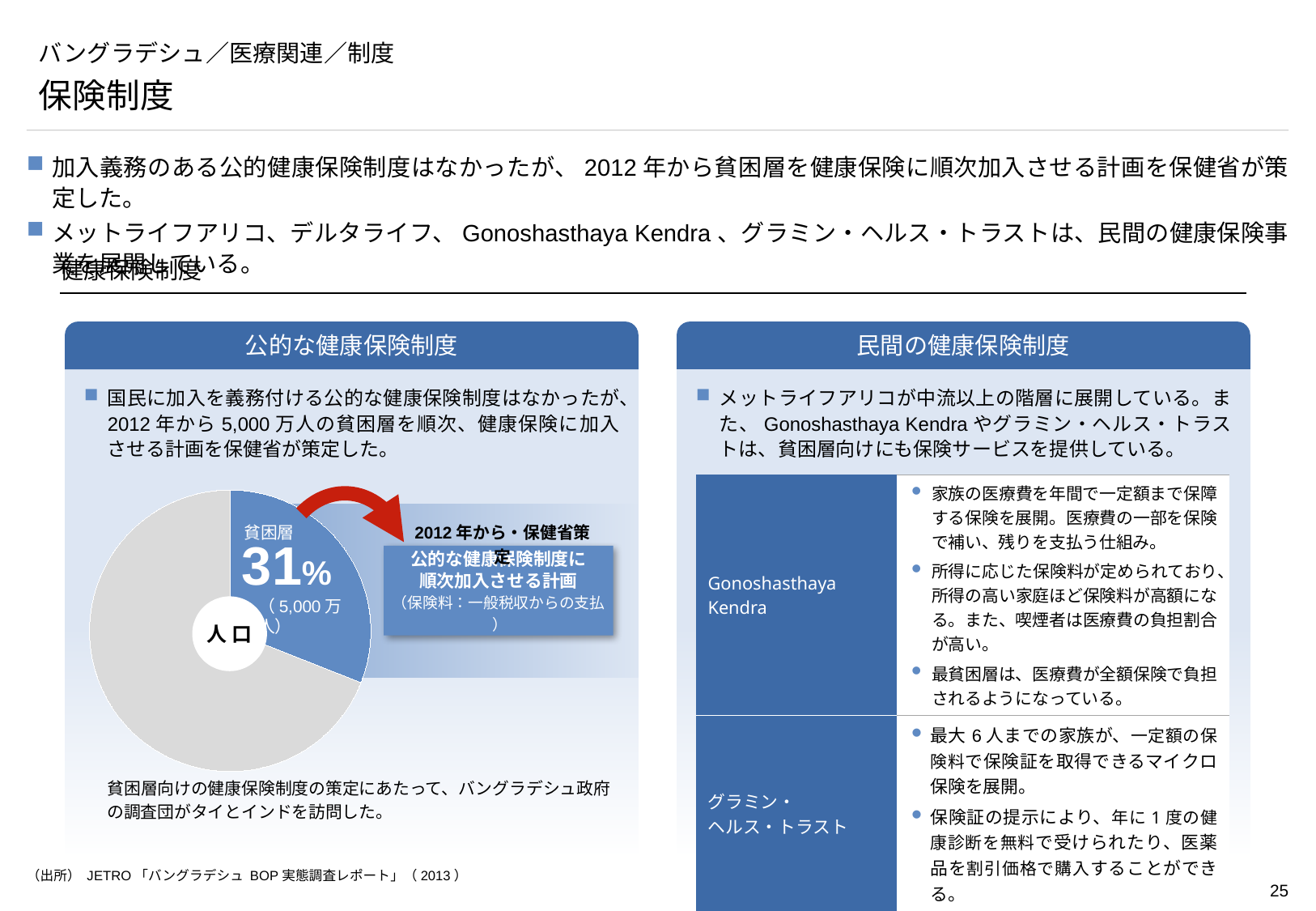
What label appears in the centre of the donut chart? 人口 What percentage of the population does the 貧困層 slice of the pie chart represent? 31% Which is larger in the pie chart: the 貧困層 slice or the remaining grey slice? the remaining grey slice According to the pie chart annotation, how many people does the 貧困層 slice correspond to? 5,000万人 How many slices does the pie chart have? 2 Is the 貧困層 share in the pie chart greater or less than 50%? less What colour is the 貧困層 slice in the pie chart? blue What kind of chart is shown on the left side of the slide under 公的な健康保険制度? pie chart (donut)